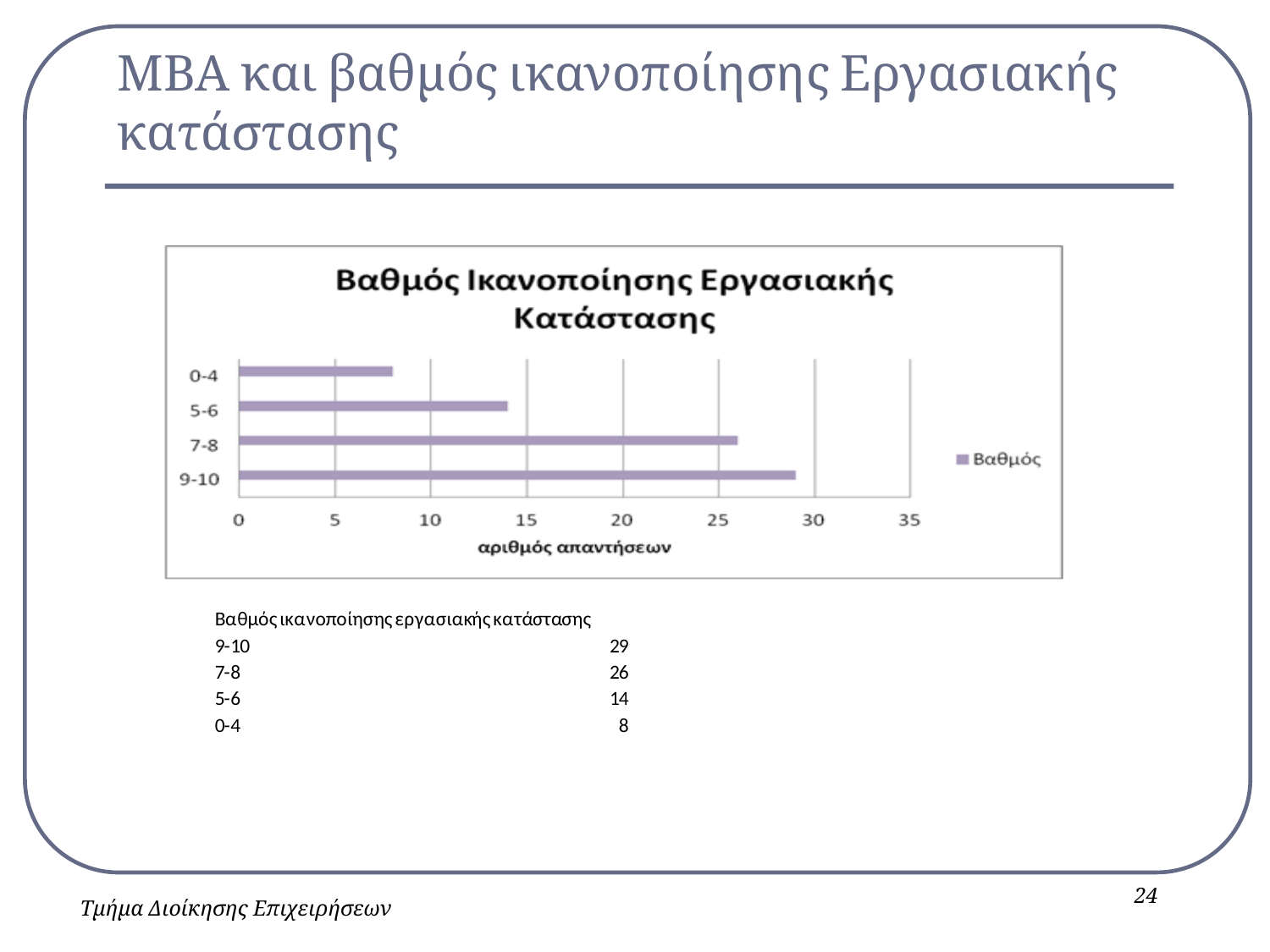
Which category has the highest number of responses? 9-10 What is the difference between the values for 9-10 and 7-8? 3 Which category has the lowest number of responses? 0-4 How many series does the legend list? 1 How many categories does the chart show? 4 What is the value for the 0-4 category? 8 What kind of chart is shown on the slide? bar chart Which is larger, the value for 5-6 or the value for 7-8? 7-8 What is the title of the chart? Βαθμός Ικανοποίησης Εργασιακής Κατάστασης Is the value for 7-8 greater or less than 25? greater What is the value for the 5-6 category? 14 What is the value for the 9-10 category? 29